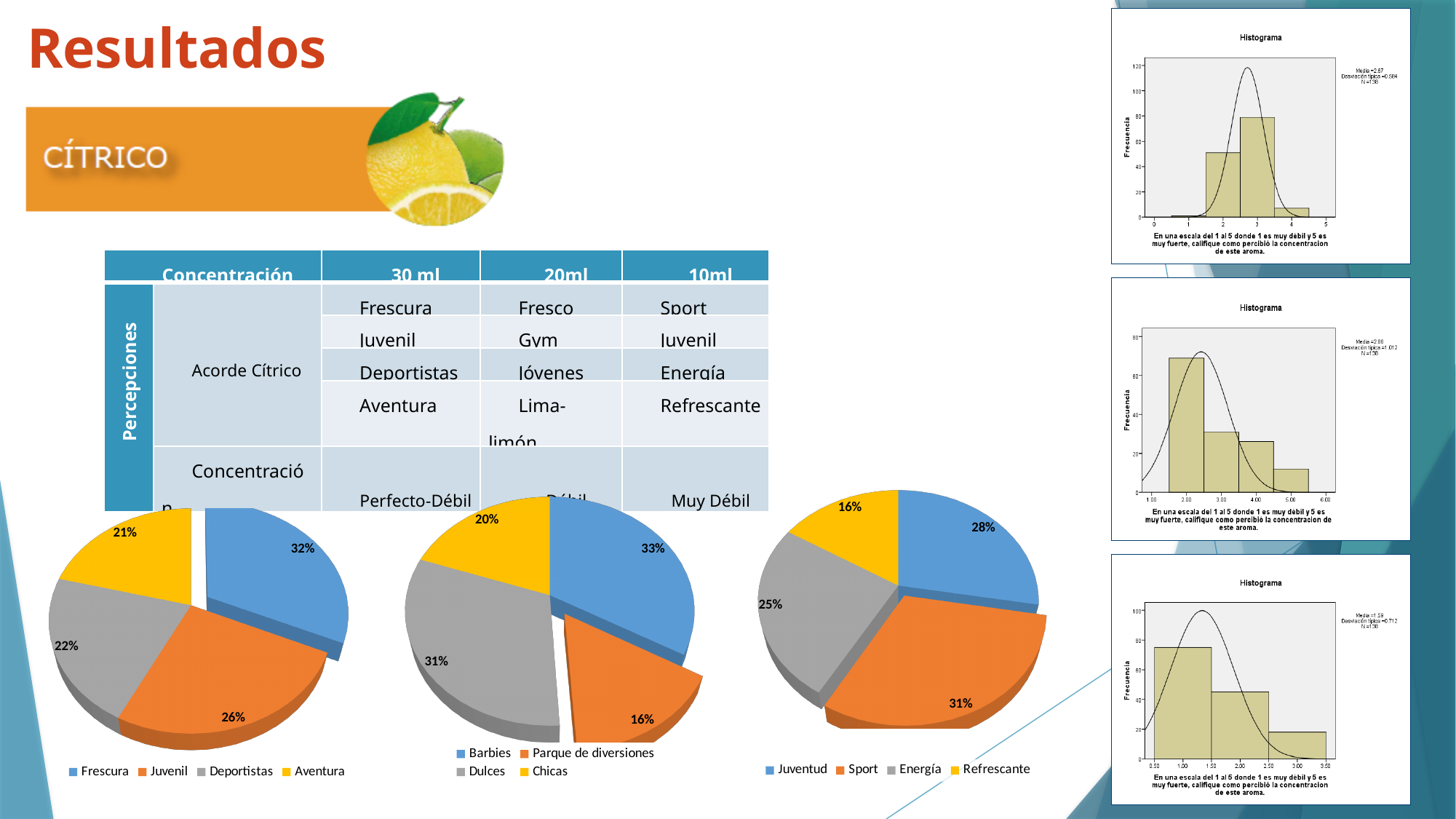
In the right pie chart, what is the difference between the Juventud and Refrescante shares? 12% In the middle pie chart, which category has the largest share? Barbies In the middle pie chart, which is larger, Dulces or Chicas? Dulces In the left pie chart, what is the difference between the Juvenil and Deportistas shares? 4% In the right pie chart, which category has the largest share? Sport In the left pie chart, what share does Frescura have? 32% In the left pie chart, which category has the smallest share? Aventura How many categories does the legend of the left pie chart list? 4 What type of chart are the three charts along the bottom of the slide? Pie chart In the middle pie chart, what is the combined share of Barbies and Dulces? 64% In the right pie chart, what share does Energía have? 25% In the middle pie chart, what share does Parque de diversiones have? 16%